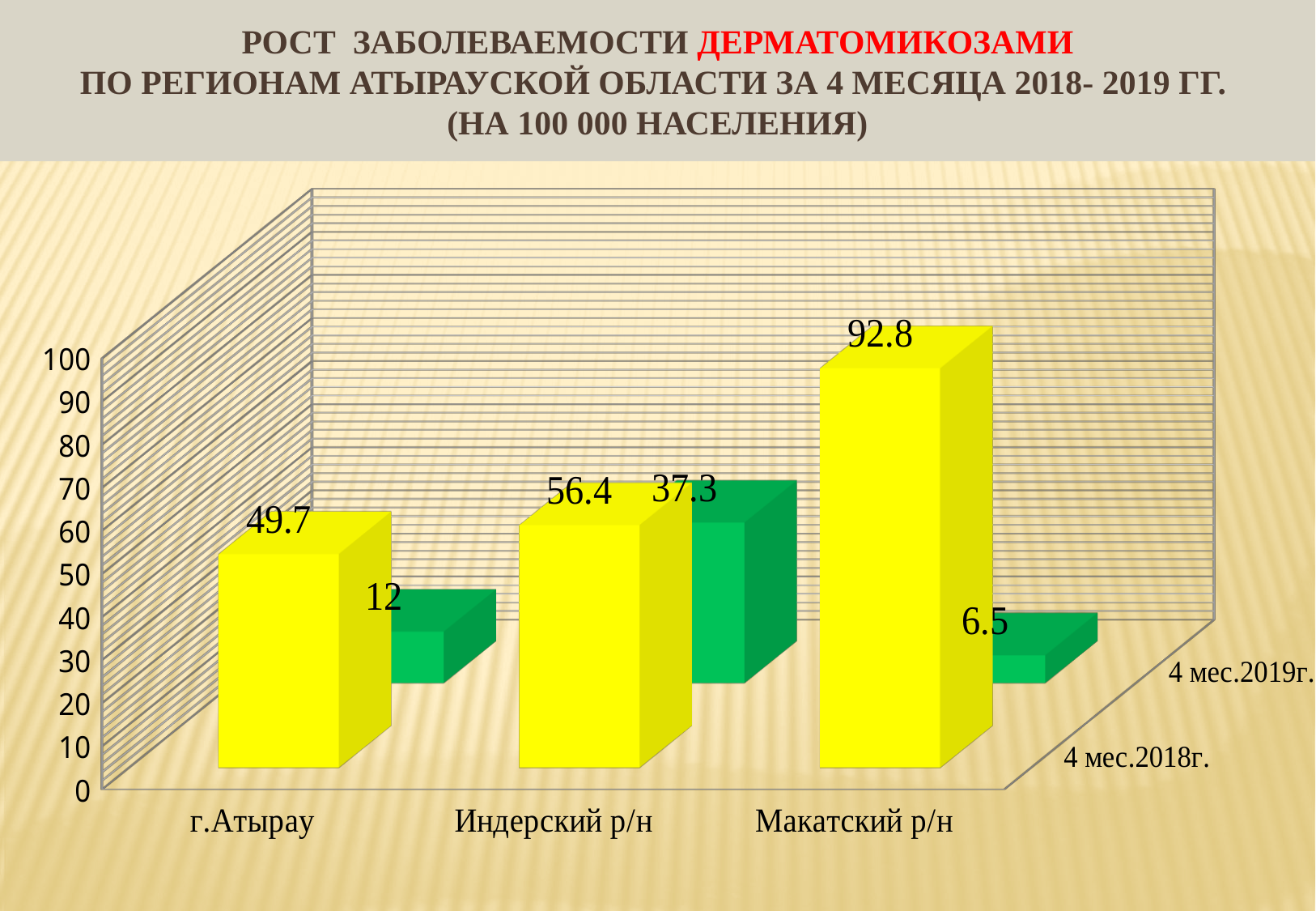
What is the value for Макатский р/н for 4 мес.2018г.? 92.8 Which is larger for 4 мес.2018г.: г.Атырау or Индерский р/н? Индерский р/н What is the difference between the 4 мес.2018г. and 4 мес.2019г. values for Макатский р/н? 86.3 What is the value for Индерский р/н for 4 мес.2019г.? 37.3 How many data series does the chart show? 2 What kind of chart is shown on the slide? bar chart What is the value for Макатский р/н for 4 мес.2019г.? 6.5 Which region has the lowest value for 4 мес.2019г.? Макатский р/н Which region has the highest value for 4 мес.2018г.? Макатский р/н What is the difference between the 4 мес.2018г. and 4 мес.2019г. values for Индерский р/н? 19.1 What is the value for г.Атырау for 4 мес.2018г.? 49.7 How many regions are shown on the x axis? 3